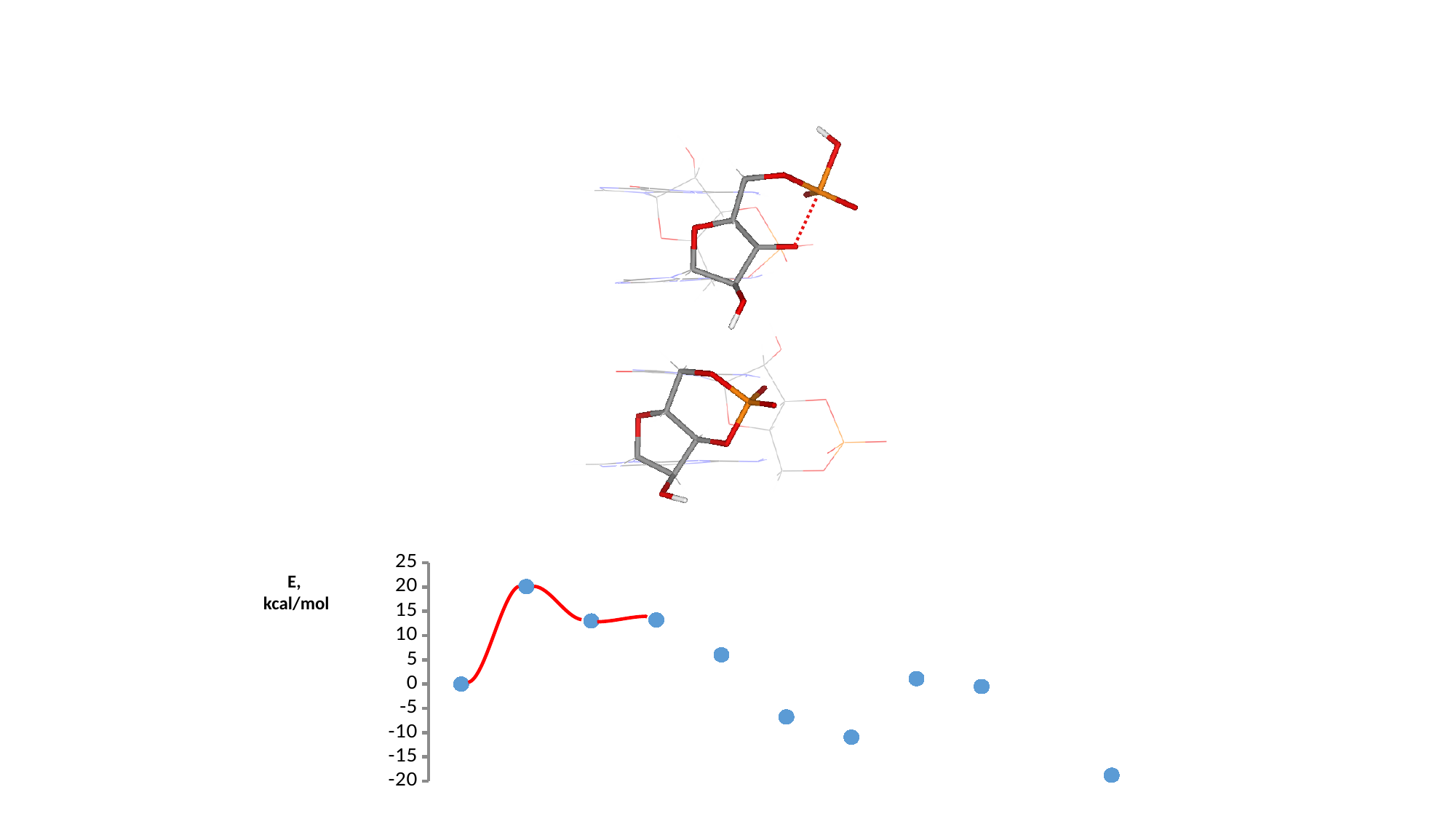
Is the value of the fifth point from the left greater or less than 10? less How many data points are plotted in the chart? 10 What kind of chart is shown at the bottom of the slide? scatter chart What are the minimum and maximum values shown on the vertical axis of the chart? -20 and 25 Which is larger, the value of the second point from the left or the value of the rightmost point? the second point from the left Which data point has the highest value in the chart? the second point from the left Is the value of the leftmost point in the chart greater or less than 5? less Do the values in the chart generally rise or fall from the second point onward moving to the right? fall What is the label on the vertical axis of the chart? E, kcal/mol Is the value of the rightmost point in the chart greater or less than -15? less Which data point has the lowest value in the chart? the rightmost point